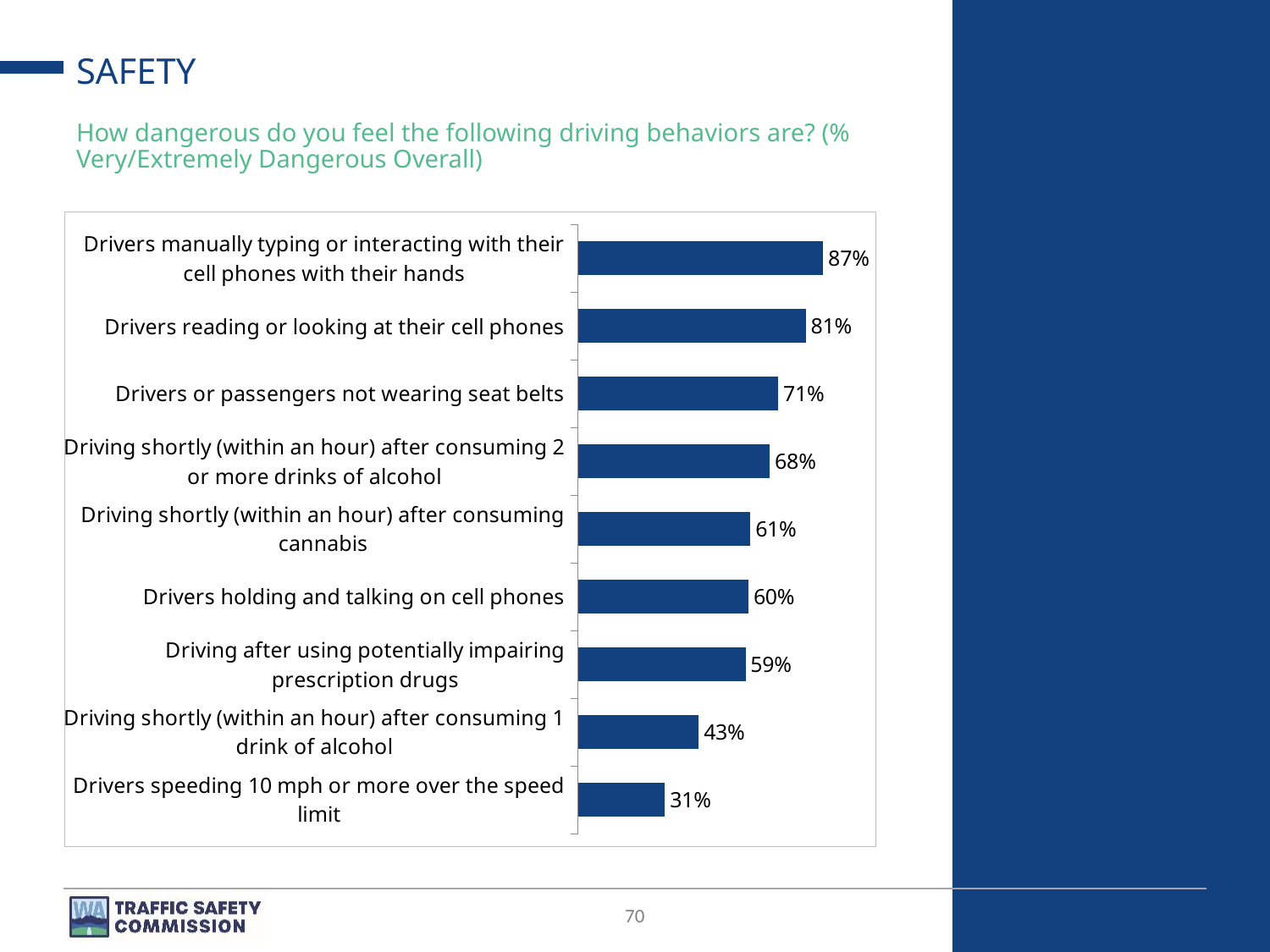
How many driving behaviors are shown in the chart? 9 Which driving behavior has the highest percentage rated very/extremely dangerous? Drivers manually typing or interacting with their cell phones with their hands What question does the chart's title say respondents were asked? How dangerous do you feel the following driving behaviors are? What is the value for driving shortly (within an hour) after consuming cannabis? 61% What percentage of respondents rated drivers manually typing or interacting with their cell phones with their hands as very/extremely dangerous? 87% What type of chart is shown on the slide? Bar chart What is the value for drivers or passengers not wearing seat belts? 71% Which driving behavior has the lowest percentage rated very/extremely dangerous? Drivers speeding 10 mph or more over the speed limit What is the difference between the value for drivers reading or looking at their cell phones and the value for drivers holding and talking on cell phones? 21% What is the value for drivers speeding 10 mph or more over the speed limit? 31% Which is larger: the value for driving after using potentially impairing prescription drugs or the value for driving shortly after consuming 1 drink of alcohol? Driving after using potentially impairing prescription drugs What is the difference between the value for driving shortly after consuming 2 or more drinks of alcohol and the value for driving shortly after consuming 1 drink of alcohol? 25%